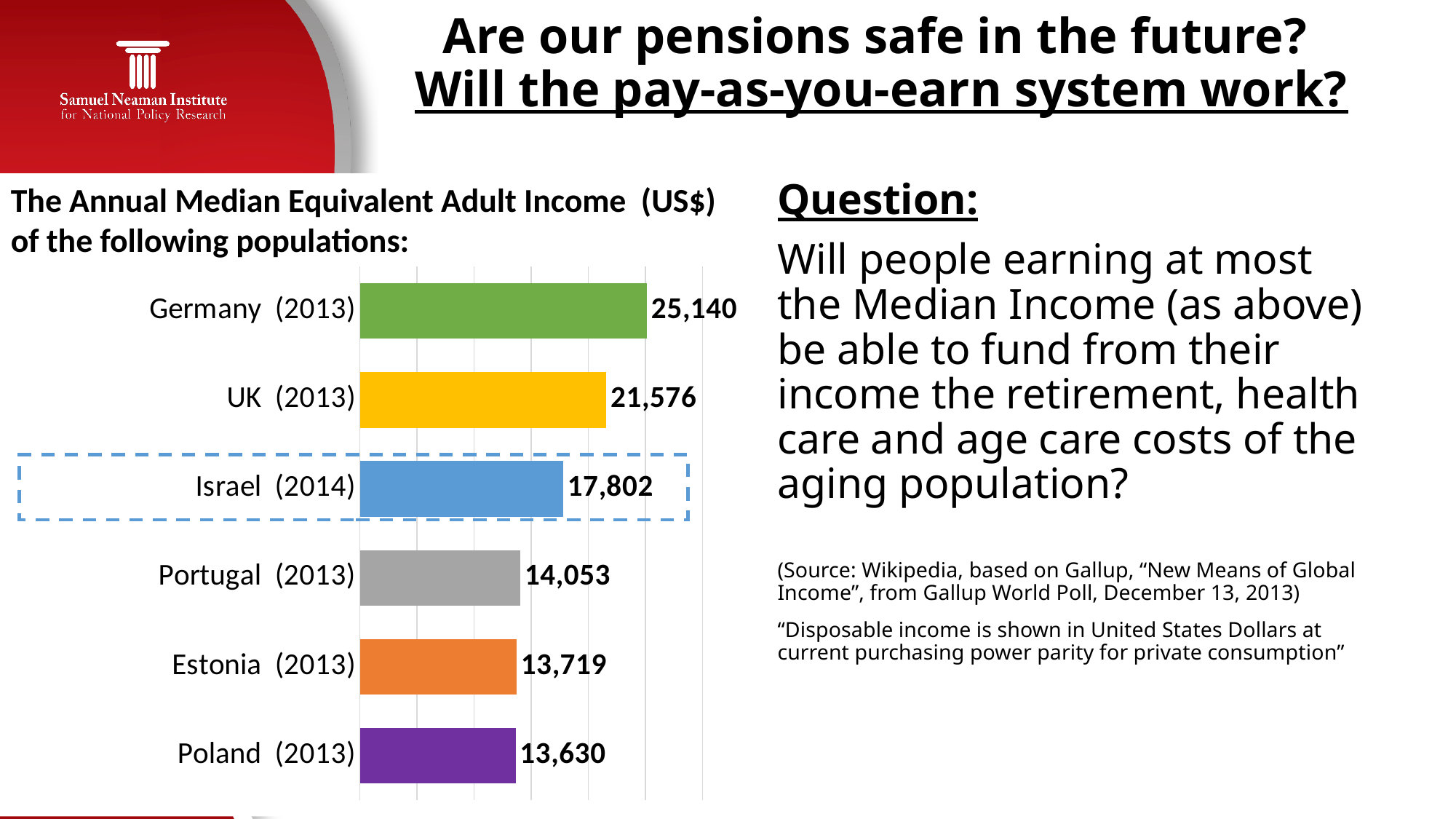
What kind of chart is used to show the annual median equivalent adult income? Bar chart What is the difference between the values for Germany (2013) and UK (2013)? 3,564 Which is larger, the value for UK (2013) or the value for Israel (2014)? UK (2013) How many populations are shown on the chart? 6 Which is larger, the value for Portugal (2013) or the value for Poland (2013)? Portugal (2013) What is the annual median equivalent adult income shown for Germany (2013)? 25,140 Which population has the highest annual median equivalent adult income on the chart? Germany (2013) What is the difference between the values for Israel (2014) and Portugal (2013)? 3,749 Which population has the lowest annual median equivalent adult income on the chart? Poland (2013) What is the value shown for Estonia (2013)? 13,719 Which bar on the chart is highlighted with a dashed outline? Israel (2014) What is the value shown for Israel (2014)? 17,802